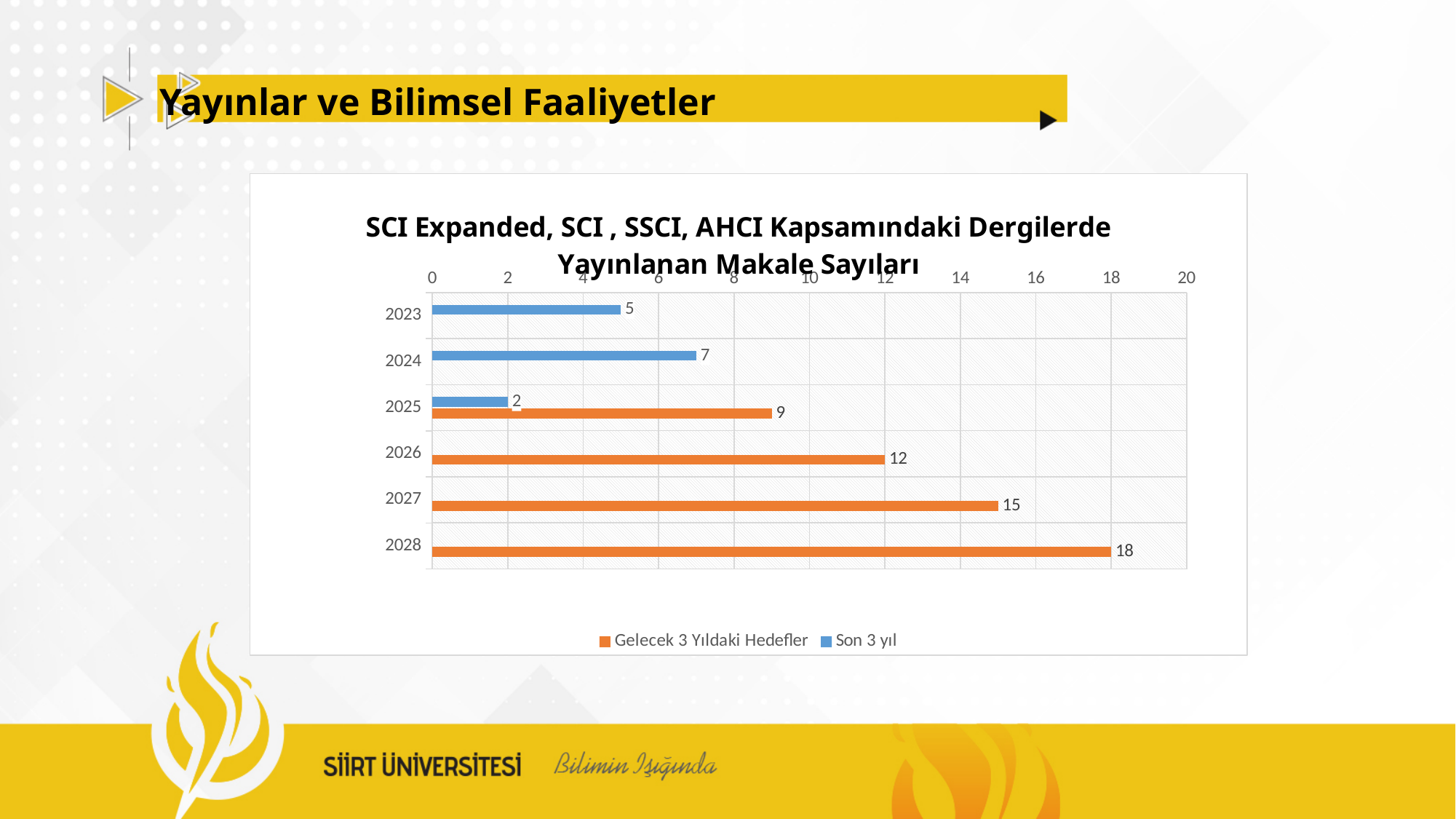
How many years are shown on the vertical axis? 6 Do the 'Gelecek 3 Yıldaki Hedefler' values rise or fall from 2025 to 2028? Rise Which is larger: the 'Son 3 yıl' value for 2024 or for 2023? 2024 Which year has the lowest 'Son 3 yıl' value? 2025 How many series does the legend list? 2 What kind of chart is shown? Bar chart What is the value for 2023 in the 'Son 3 yıl' series? 5 What is the 'Gelecek 3 Yıldaki Hedefler' value for 2028? 18 What is the 'Gelecek 3 Yıldaki Hedefler' value for 2025? 9 What is the difference between the 'Gelecek 3 Yıldaki Hedefler' values for 2028 and 2027? 3 Which year has the highest 'Gelecek 3 Yıldaki Hedefler' value? 2028 What is the value for 2024 in the 'Son 3 yıl' series? 7